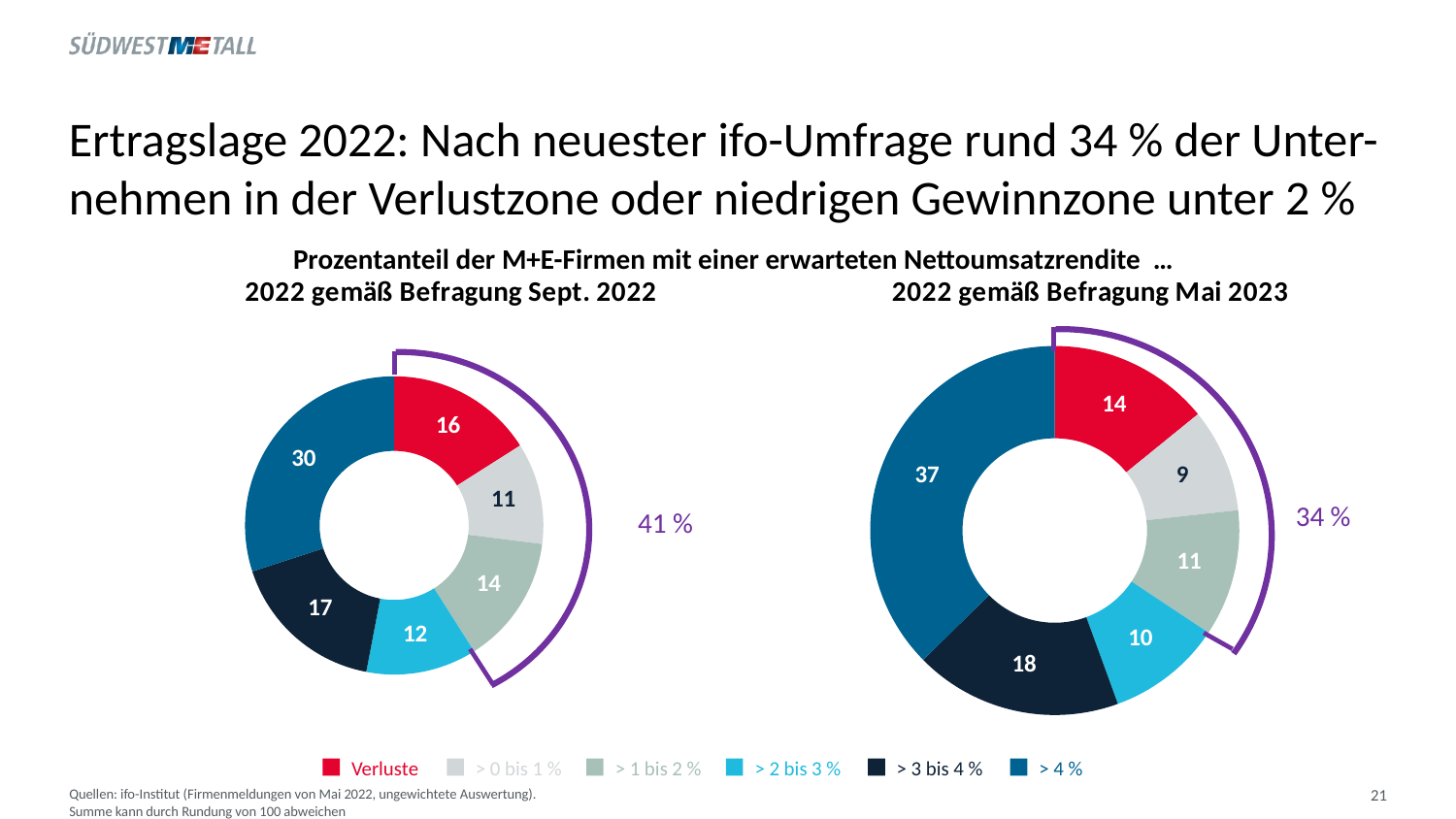
In the chart '2022 gemäß Befragung Sept. 2022', what is the value for 'Verluste'? 16 How many categories does the legend list for the charts? 6 What kind of chart is used on this slide? Donut (pie) chart In the chart '2022 gemäß Befragung Mai 2023', what is the value for '> 0 bis 1 %'? 9 In the chart '2022 gemäß Befragung Mai 2023', what is the difference between the values for '> 4 %' and '> 3 bis 4 %'? 19 In the chart '2022 gemäß Befragung Sept. 2022', what is the value for '> 3 bis 4 %'? 17 What percentage is shown next to the purple bracket on the chart '2022 gemäß Befragung Mai 2023'? 34 % Is the value for 'Verluste' larger in the chart '2022 gemäß Befragung Sept. 2022' or in the chart '2022 gemäß Befragung Mai 2023'? 2022 gemäß Befragung Sept. 2022 In the chart '2022 gemäß Befragung Mai 2023', what is the value for '> 4 %'? 37 In the chart '2022 gemäß Befragung Sept. 2022', which is larger: the value for '> 1 bis 2 %' or the value for '> 2 bis 3 %'? > 1 bis 2 % In the chart '2022 gemäß Befragung Mai 2023', which category has the smallest value? > 0 bis 1 % In the chart '2022 gemäß Befragung Sept. 2022', which category has the largest value? > 4 %